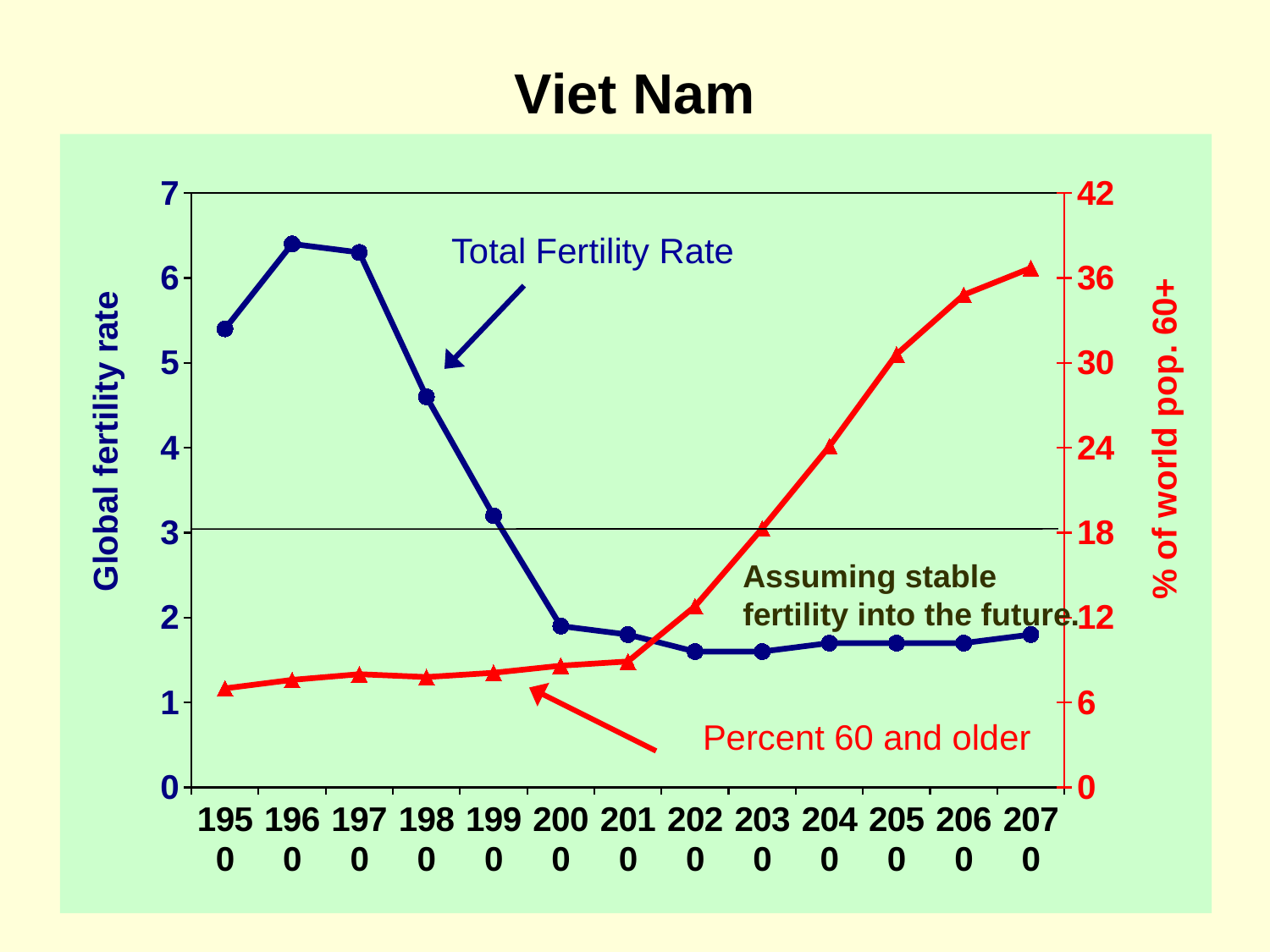
Is the Total Fertility Rate for 1960 greater or less than 6? greater Which series is drawn in red? Percent 60 and older Is the Total Fertility Rate for 1980 greater or less than 4? greater What kind of chart is shown on the slide? line chart Does the Total Fertility Rate rise or fall between 1970 and 2000? fall How many years (points) are plotted along the x axis? 13 How many data series are plotted on the chart? 2 In which year is the Percent 60 and older series at its highest? 2070 In which year is the Percent 60 and older series at its lowest? 1950 Is the Percent 60 and older value for 2010 greater or less than 12? less